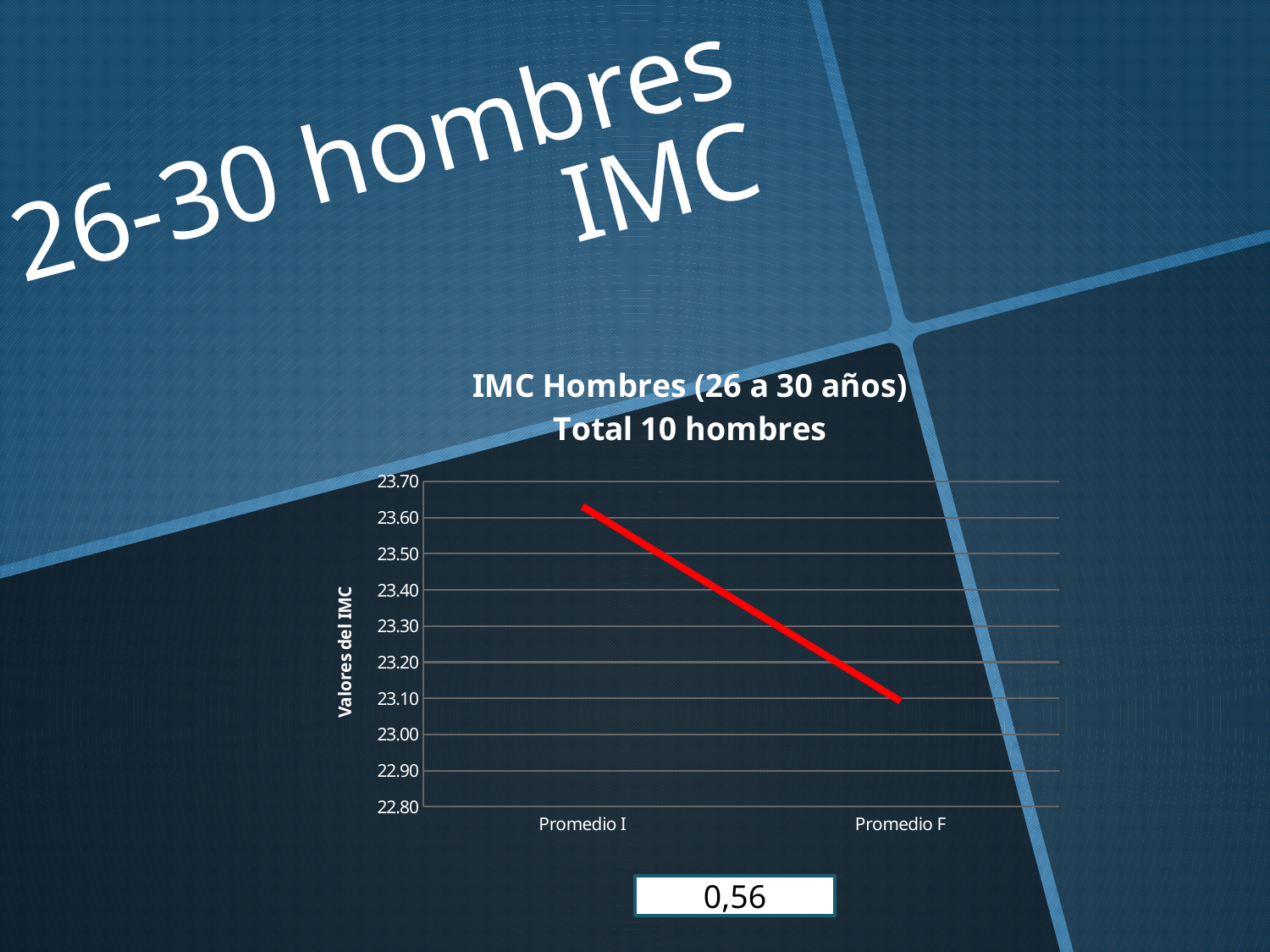
Is the value for Promedio F greater or less than 23.20? less Which category has the higher value, Promedio I or Promedio F? Promedio I Is the value for Promedio I greater or less than 23.50? greater What is the title of the chart? IMC Hombres (26 a 30 años) Total 10 hombres Which category has the lowest value? Promedio F Is the value for Promedio I greater or less than 23.70? less What is the label of the vertical axis? Valores del IMC Do the values rise or fall from Promedio I to Promedio F? fall Which category has the highest value? Promedio I How many categories are plotted on the x axis? 2 What kind of chart is shown on the slide? line chart